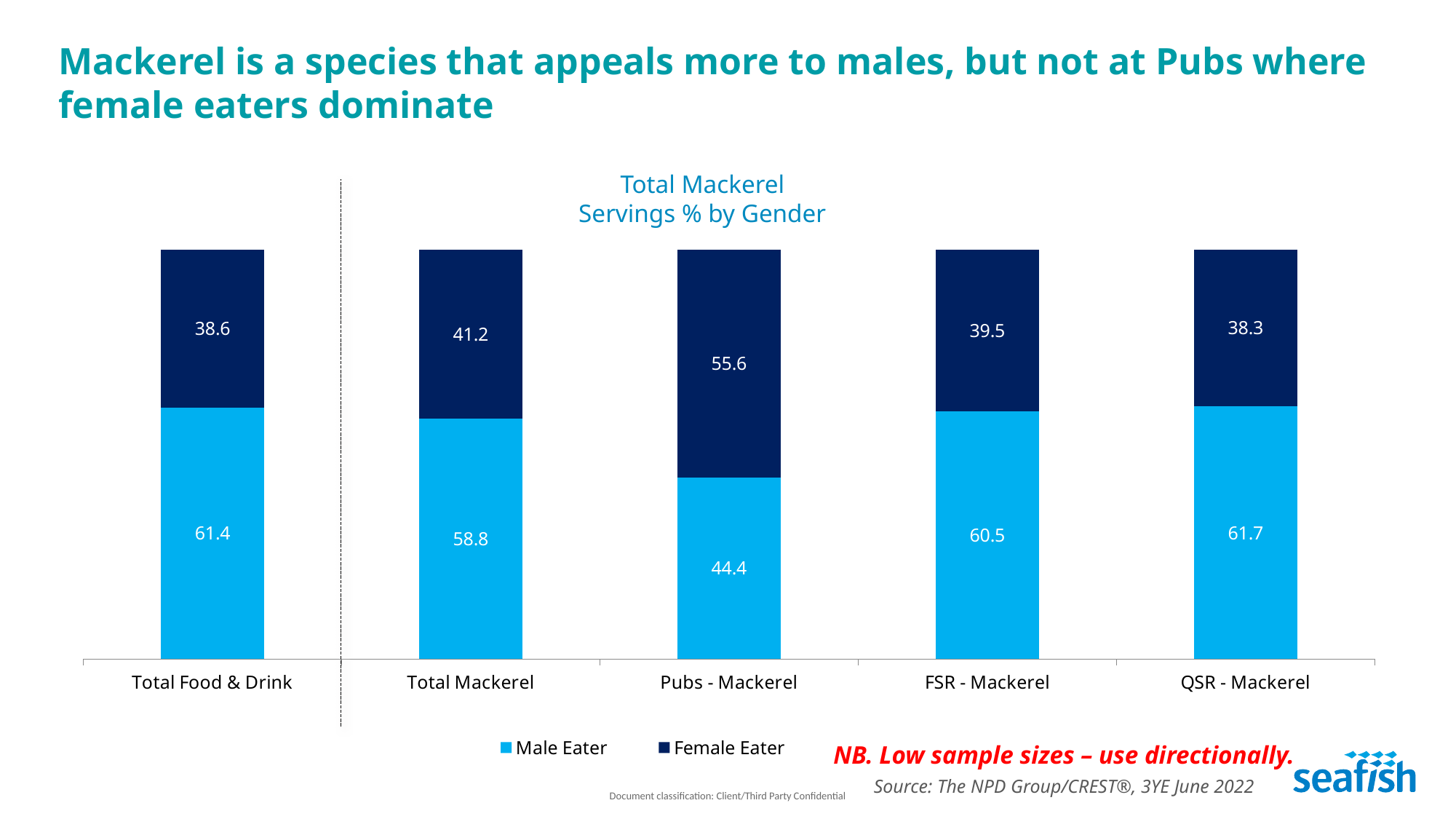
What is the Female Eater value for Total Food & Drink? 38.6 How many categories are shown on the x axis? 5 Which is larger for Pubs - Mackerel, the Male Eater value or the Female Eater value? Female Eater What is the Male Eater value for QSR - Mackerel? 61.7 What is the difference between the Male Eater and Female Eater values for Total Mackerel? 17.6 Which category has the highest Female Eater value? Pubs - Mackerel What kind of chart is shown on the slide? Stacked bar chart What is the Male Eater value for Pubs - Mackerel? 44.4 What is the title of the chart? Total Mackerel Servings % by Gender How many series does the legend list? 2 Which category has the lowest Male Eater value? Pubs - Mackerel What is the Female Eater value for FSR - Mackerel? 39.5